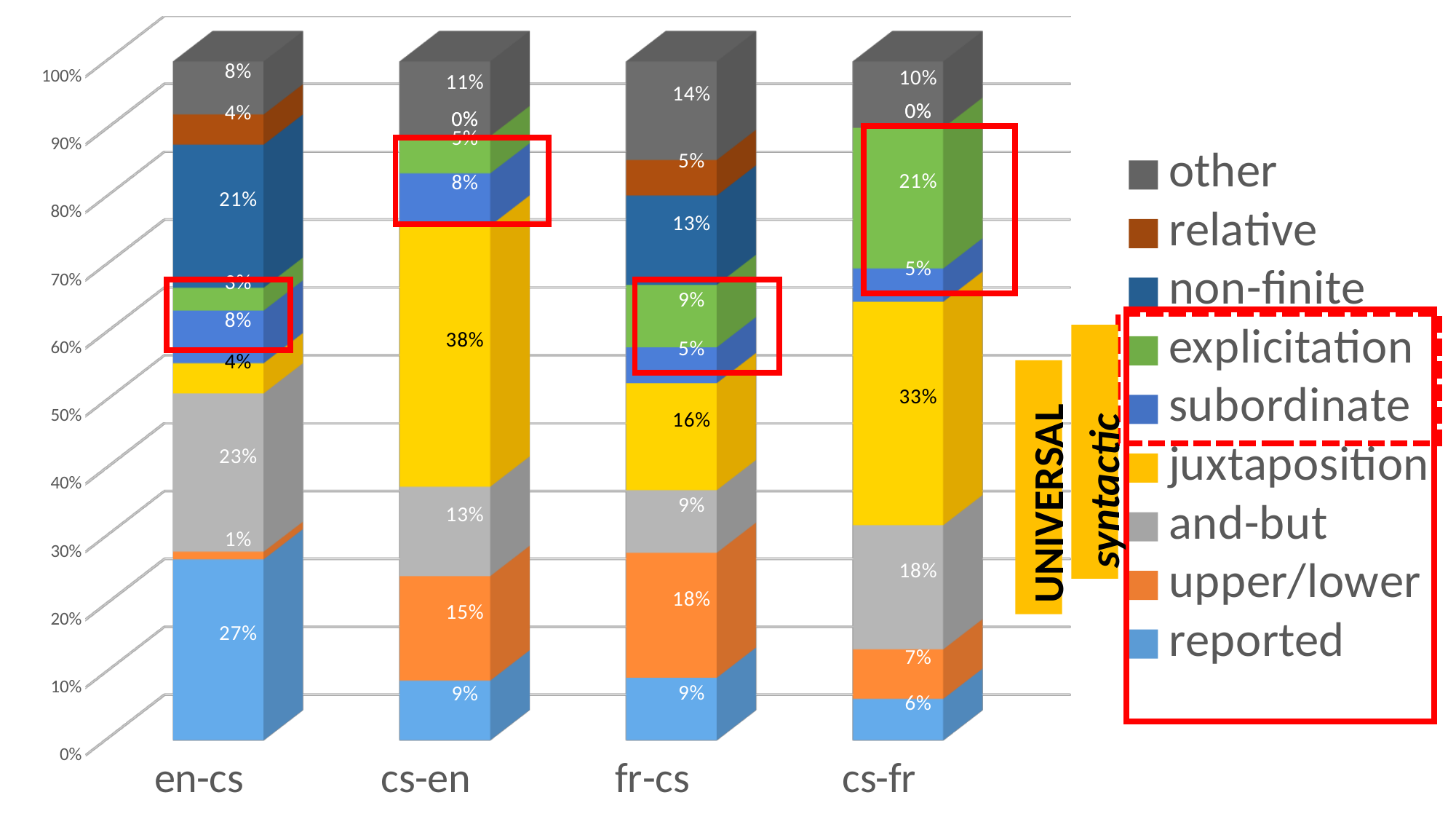
What is the value of the non-finite segment for fr-cs? 13% What is the difference between the juxtaposition values for cs-en and cs-fr? 5% How many series does the legend list? 9 Which language pair has the highest reported share? en-cs Which two legend entries are enclosed by the dashed red box? explicitation and subordinate What kind of chart is shown on the slide? stacked bar chart What is the value of the juxtaposition segment for cs-en? 38% Which is larger, the upper/lower value for fr-cs or for cs-fr? fr-cs What is the value of the reported segment for en-cs? 27% Which language pair has the lowest juxtaposition share? en-cs What is the value of the explicitation segment for cs-fr? 21% How many language-pair categories are shown on the x axis? 4